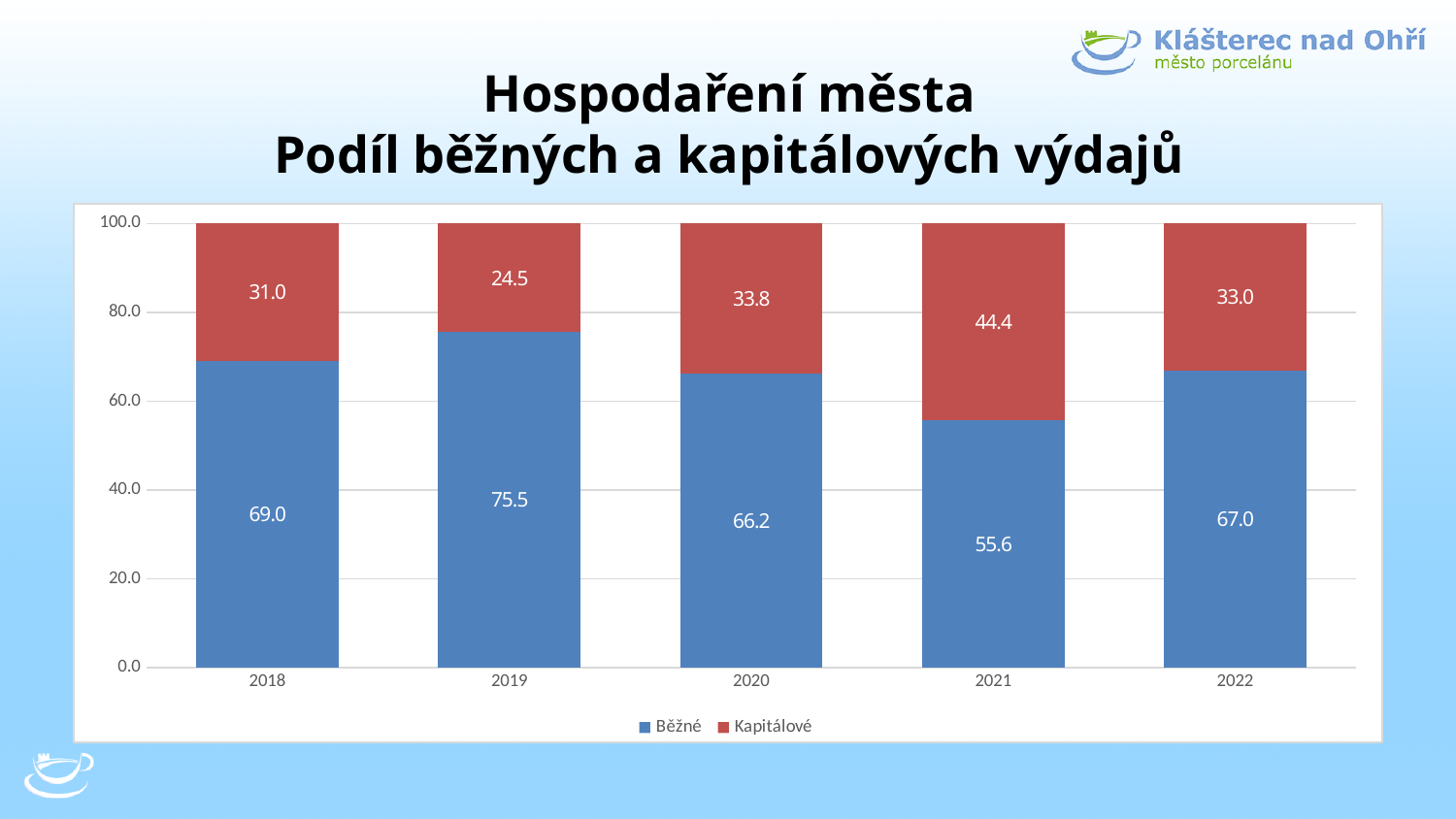
How many series does the legend list? 2 Which is larger: the Kapitálové value in 2018 or in 2022? 2022 What kind of chart is shown on the slide? stacked bar chart Is the Běžné value for 2021 greater or less than 60.0? less What is the value for Kapitálové in 2021? 44.4 What is the value for Běžné in 2020? 66.2 What is the total of the stacked bar for 2020? 100.0 What is the value for Běžné in 2019? 75.5 In which year is the Kapitálové value highest? 2021 What is the difference between the Běžné values for 2019 and 2021? 19.9 In which year is the Běžné value lowest? 2021 How many years are shown on the x axis? 5